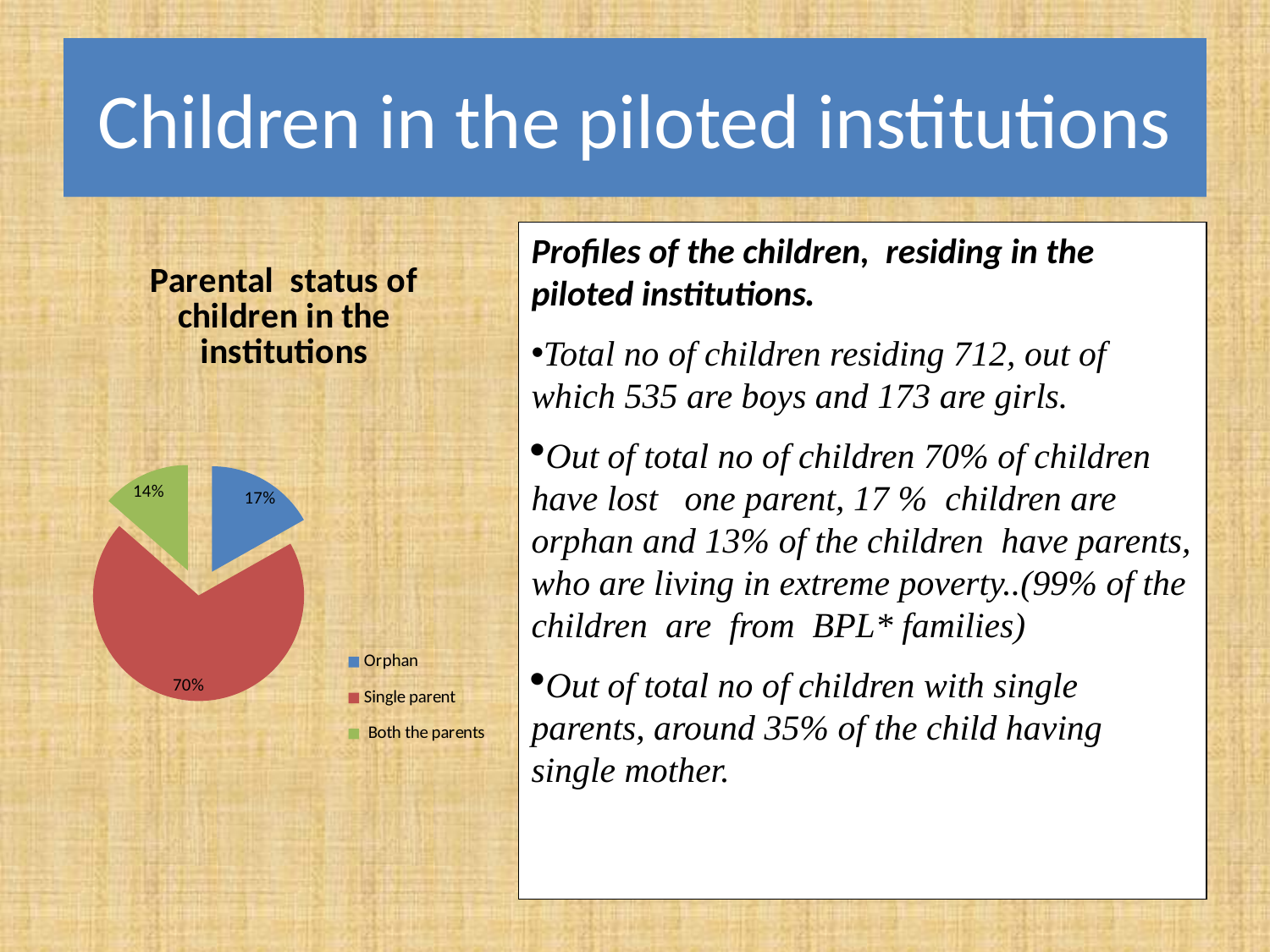
Which category has the smallest share of the pie? Both the parents What percentage of children are shown as having Both the parents in the chart? 14% Which category has the largest share of the pie? Single parent What percentage of children are shown as Orphan in the chart? 17% What type of chart is shown on the slide? Pie chart What percentage of children are shown as Single parent in the chart? 70% How many entries are listed in the chart legend? 3 What is the difference in percentage points between the Single parent slice and the Orphan slice? 53 What colour is the Single parent slice in the chart? Red Which is larger, the Orphan slice or the Both the parents slice? Orphan What is the title of the chart? Parental status of children in the institutions How many categories does the pie chart show? 3